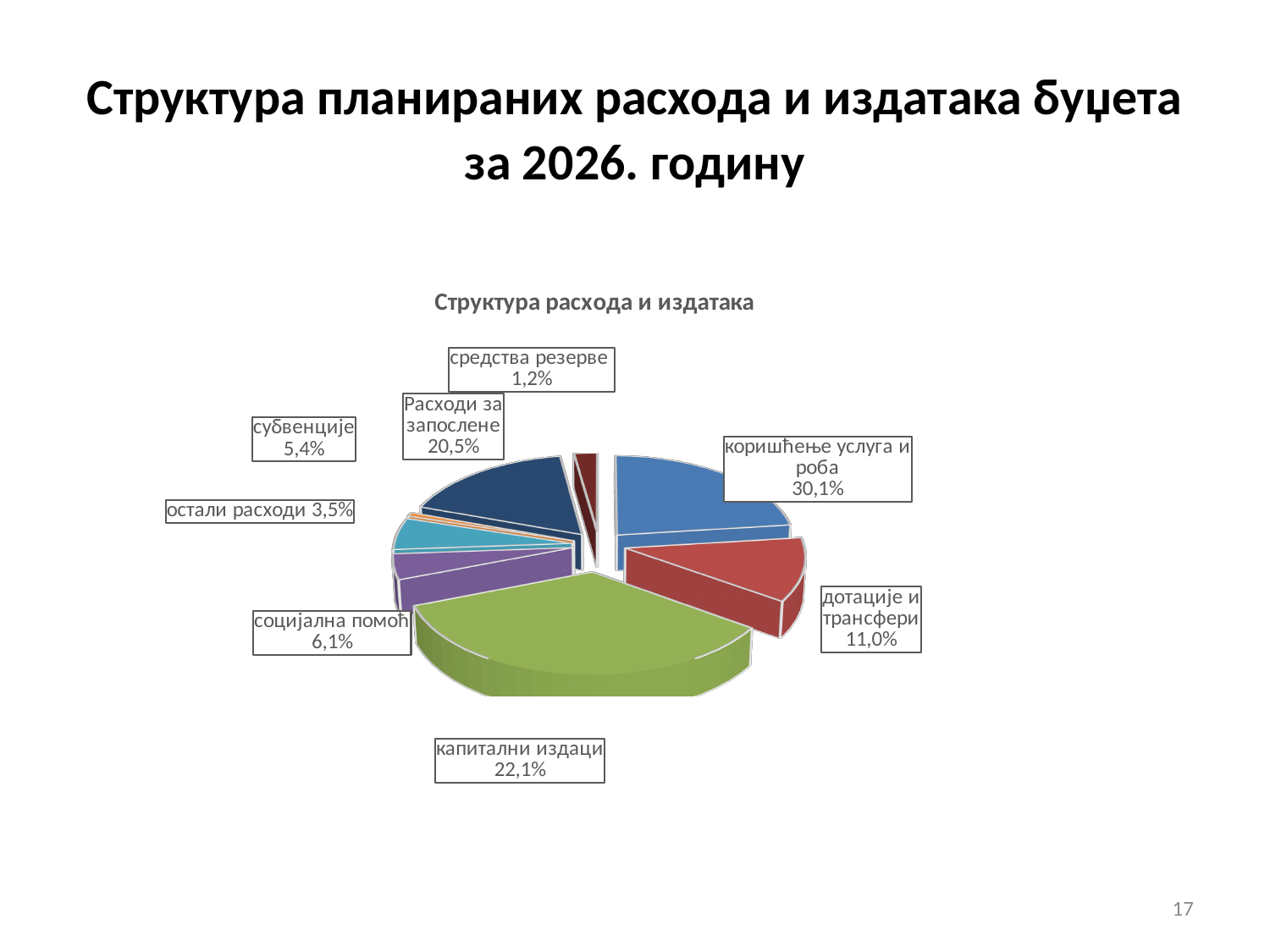
Which is larger, the share for социјална помоћ or the share for субвенције? социјална помоћ What is the value shown for капитални издаци? 22,1% Which category has the smallest share of the pie? средства резерве What share of the pie does коришћење услуга и роба have? 30,1% What kind of chart is shown on the slide? pie chart What is the title of the chart? Структура расхода и издатака Which category has the largest share of the pie? коришћење услуга и роба What is the difference between the shares of коришћење услуга и роба and капитални издаци? 8,0% How many categories are shown in the pie chart? 8 What share is labelled for средства резерве? 1,2% What percentage is shown for Расходи за запослене? 20,5% What is the value for дотације и трансфери? 11,0%